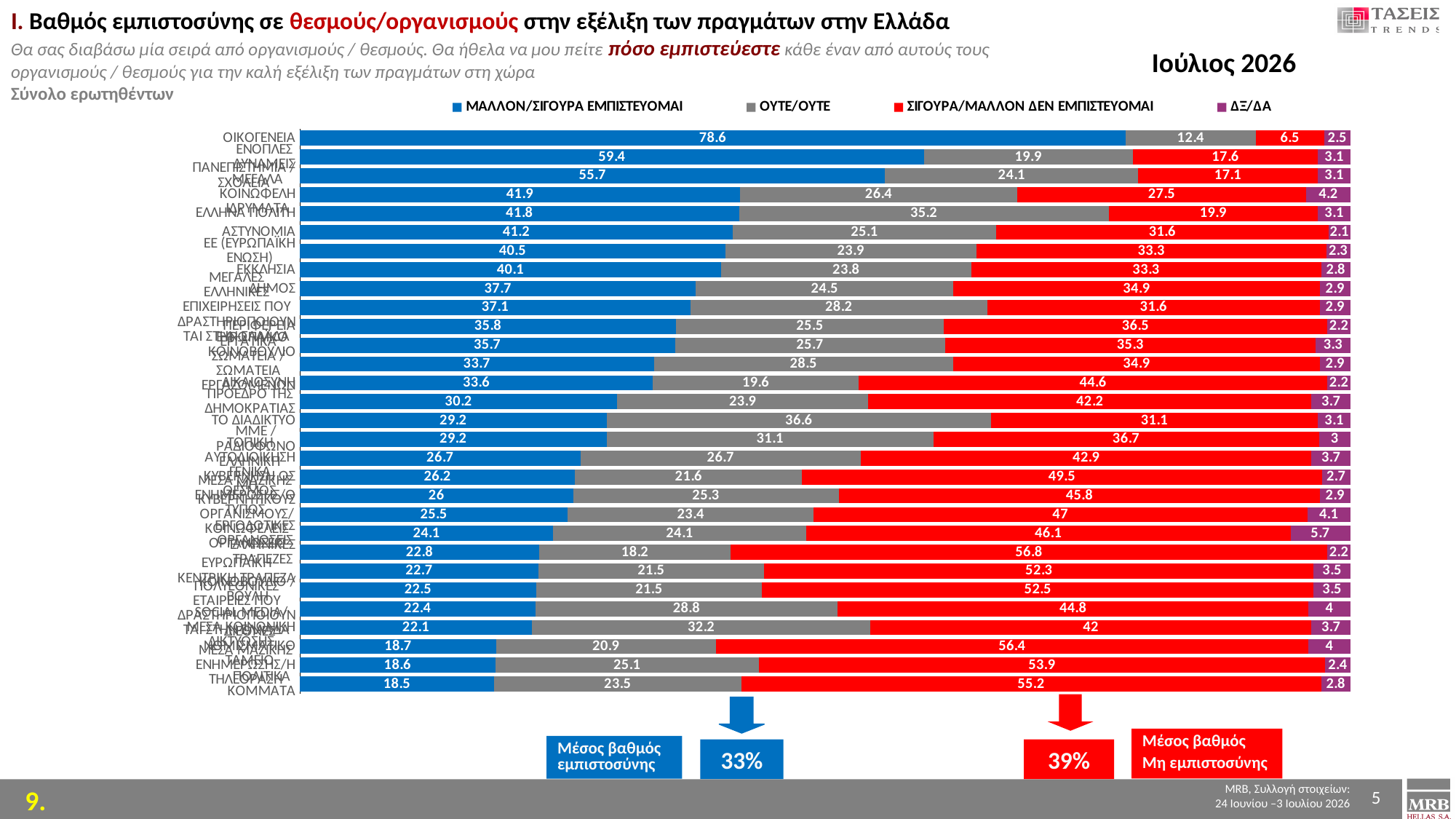
How many series does the legend list? 4 What is the total of the four segments of the ΟΙΚΟΓΕΝΕΙΑ bar? 100 What kind of chart is shown on the slide? Stacked bar chart What is the average degree of trust (Μέσος βαθμός εμπιστοσύνης) shown below the chart? 33% Which category has the highest ΜΑΛΛΟΝ/ΣΙΓΟΥΡΑ ΕΜΠΙΣΤΕΥΟΜΑΙ value? ΟΙΚΟΓΕΝΕΙΑ What is the ΜΑΛΛΟΝ/ΣΙΓΟΥΡΑ ΕΜΠΙΣΤΕΥΟΜΑΙ value for ΟΙΚΟΓΕΝΕΙΑ? 78.6 What is the difference between the ΜΑΛΛΟΝ/ΣΙΓΟΥΡΑ ΕΜΠΙΣΤΕΥΟΜΑΙ values for ΟΙΚΟΓΕΝΕΙΑ and ΚΟΜΜΑΤΑ? 60.1 What is the ΣΙΓΟΥΡΑ/ΜΑΛΛΟΝ ΔΕΝ ΕΜΠΙΣΤΕΥΟΜΑΙ value for ΚΟΜΜΑΤΑ? 55.2 What is the ΟΥΤΕ/ΟΥΤΕ value for ΤΟ ΔΙΑΔΙΚΤΥΟ? 36.6 How many institutions/organisations are plotted in the chart? 30 What is the ΔΞ/ΔΑ value for ΑΣΤΥΝΟΜΙΑ? 2.1 Which has the larger ΜΑΛΛΟΝ/ΣΙΓΟΥΡΑ ΕΜΠΙΣΤΕΥΟΜΑΙ value, ΑΣΤΥΝΟΜΙΑ or ΕΚΚΛΗΣΙΑ? ΑΣΤΥΝΟΜΙΑ